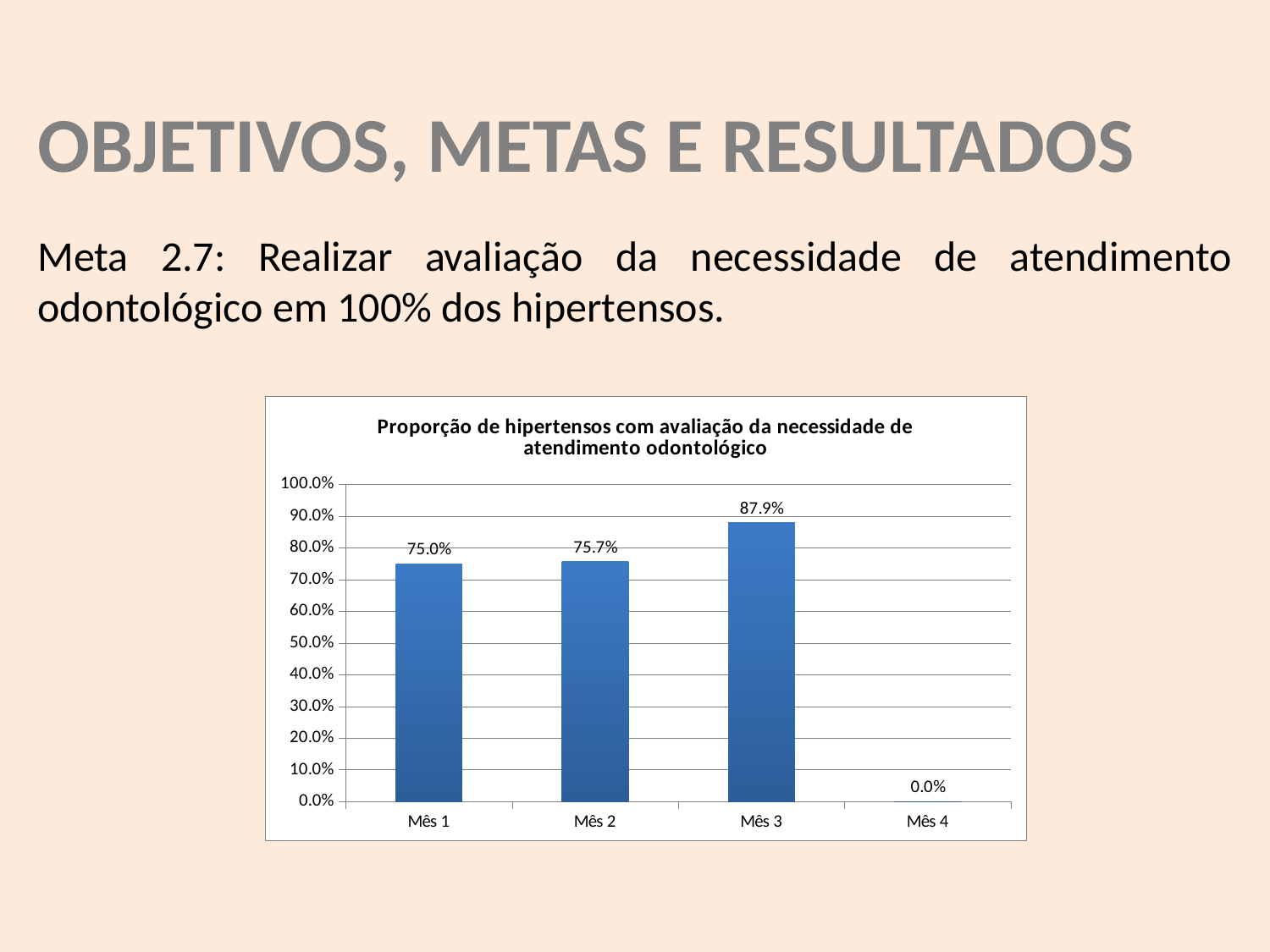
Which month has the lowest value? Mês 4 How many months are shown on the x axis? 4 What is the value for Mês 1? 75.0% What is the title of the chart? Proporção de hipertensos com avaliação da necessidade de atendimento odontológico What is the value for Mês 4? 0.0% Which month has the highest value? Mês 3 Is the value for Mês 3 greater or less than 80.0%? greater What kind of chart is shown on the slide? Bar chart What is the value for Mês 2? 75.7% Which is larger, the value for Mês 3 or the value for Mês 2? Mês 3 What is the value for Mês 3? 87.9% What is the difference between the values for Mês 3 and Mês 1? 12.9%